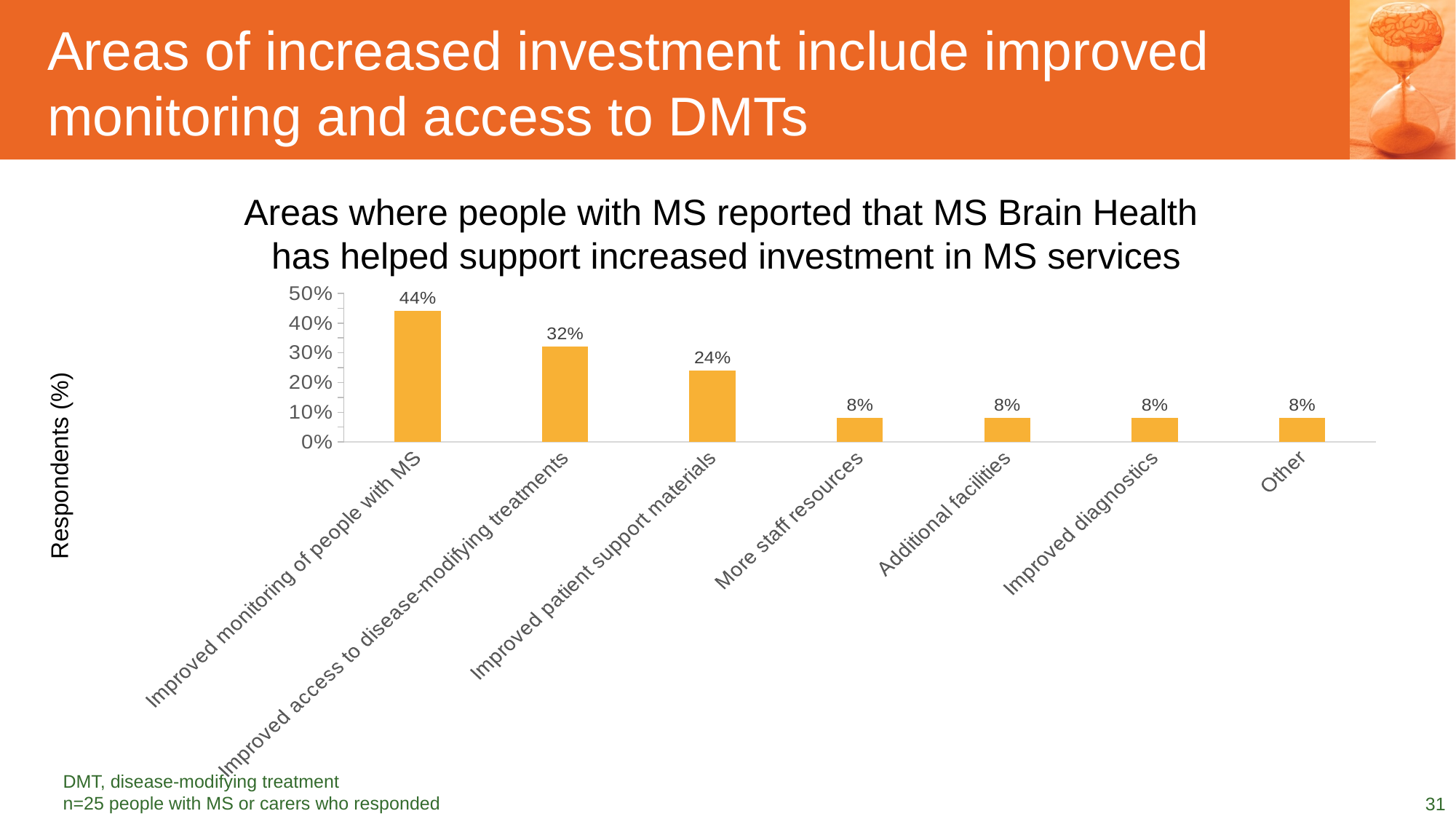
What is the difference between the percentages for improved patient support materials and improved diagnostics? 16% What kind of chart is shown on the slide? Bar chart Which is larger: the value for improved access to disease-modifying treatments or the value for improved patient support materials? Improved access to disease-modifying treatments What percentage of respondents reported improved patient support materials? 24% Which area has the highest percentage of respondents? Improved monitoring of people with MS Is the value for improved monitoring of people with MS greater or less than 40%? greater How many categories are shown on the x axis of the chart? 7 What is the label of the vertical axis of the chart? Respondents (%) What percentage of respondents reported improved access to disease-modifying treatments? 32% What is the difference between the percentages for improved monitoring of people with MS and improved access to disease-modifying treatments? 12% What percentage of respondents reported improved monitoring of people with MS? 44% What percentage of respondents reported more staff resources? 8%